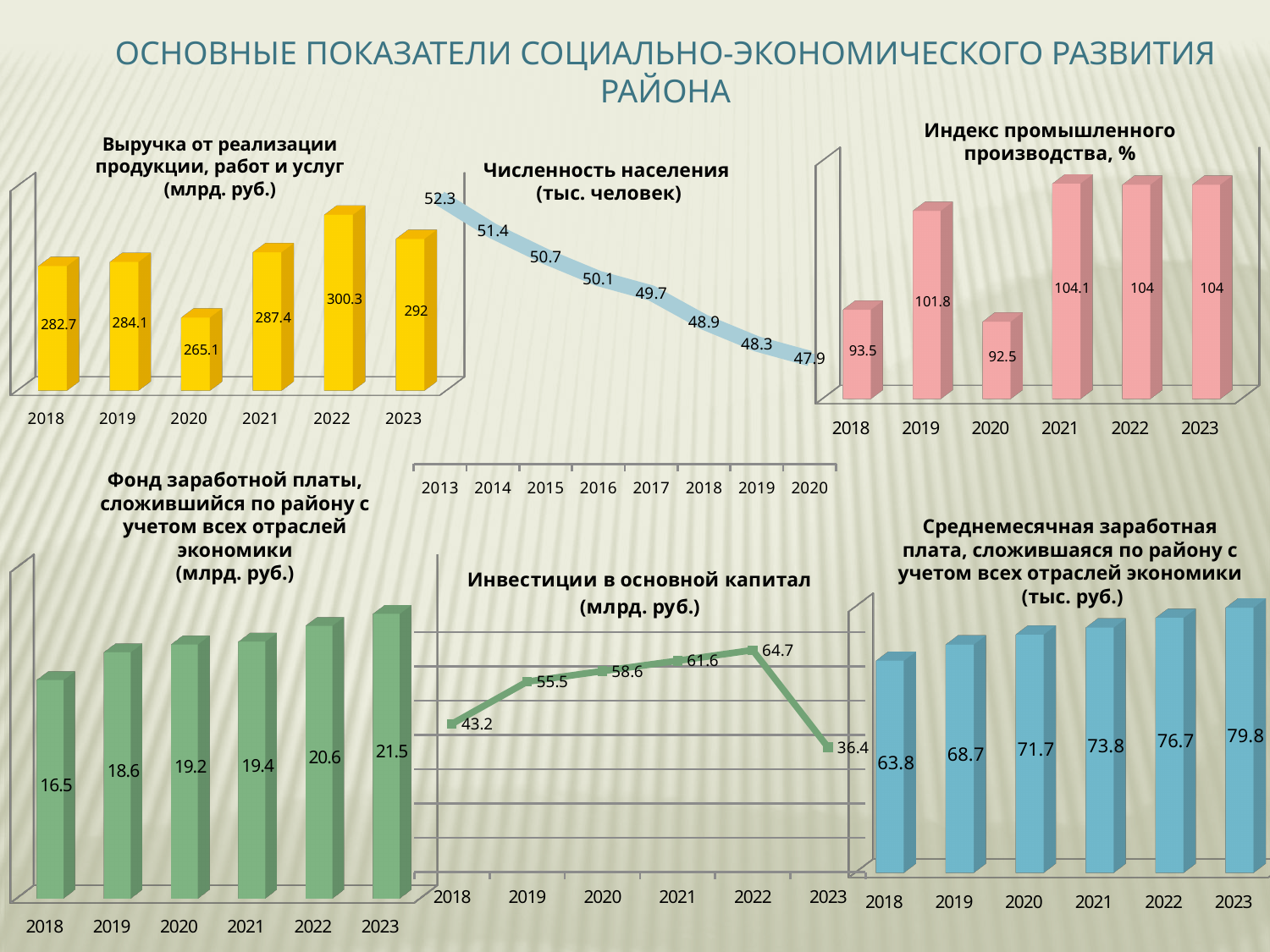
In the chart 'Индекс промышленного производства, %', which year has the highest value? 2021 In the chart 'Численность населения (тыс. человек)', do the values rise or fall from 2013 to 2020? fall In the chart 'Выручка от реализации продукции, работ и услуг (млрд. руб.)', what is the value for 2022? 300.3 In the chart 'Фонд заработной платы, сложившийся по району с учетом всех отраслей экономики (млрд. руб.)', what is the difference between the 2023 and 2018 values? 5 In the chart 'Выручка от реализации продукции, работ и услуг (млрд. руб.)', which year has the lowest value? 2020 In the chart 'Инвестиции в основной капитал (млрд. руб.)', which year has the highest value? 2022 In the chart 'Численность населения (тыс. человек)', what is the value for 2013? 52.3 In the chart 'Индекс промышленного производства, %', what is the value for 2019? 101.8 What kind of chart is 'Инвестиции в основной капитал (млрд. руб.)'? line chart In the chart 'Среднемесячная заработная плата, сложившаяся по району с учетом всех отраслей экономики (тыс. руб.)', which is larger, the value for 2020 or the value for 2021? 2021 In the chart 'Численность населения (тыс. человек)', how many data points are plotted? 8 In the chart 'Инвестиции в основной капитал (млрд. руб.)', what is the value for 2023? 36.4